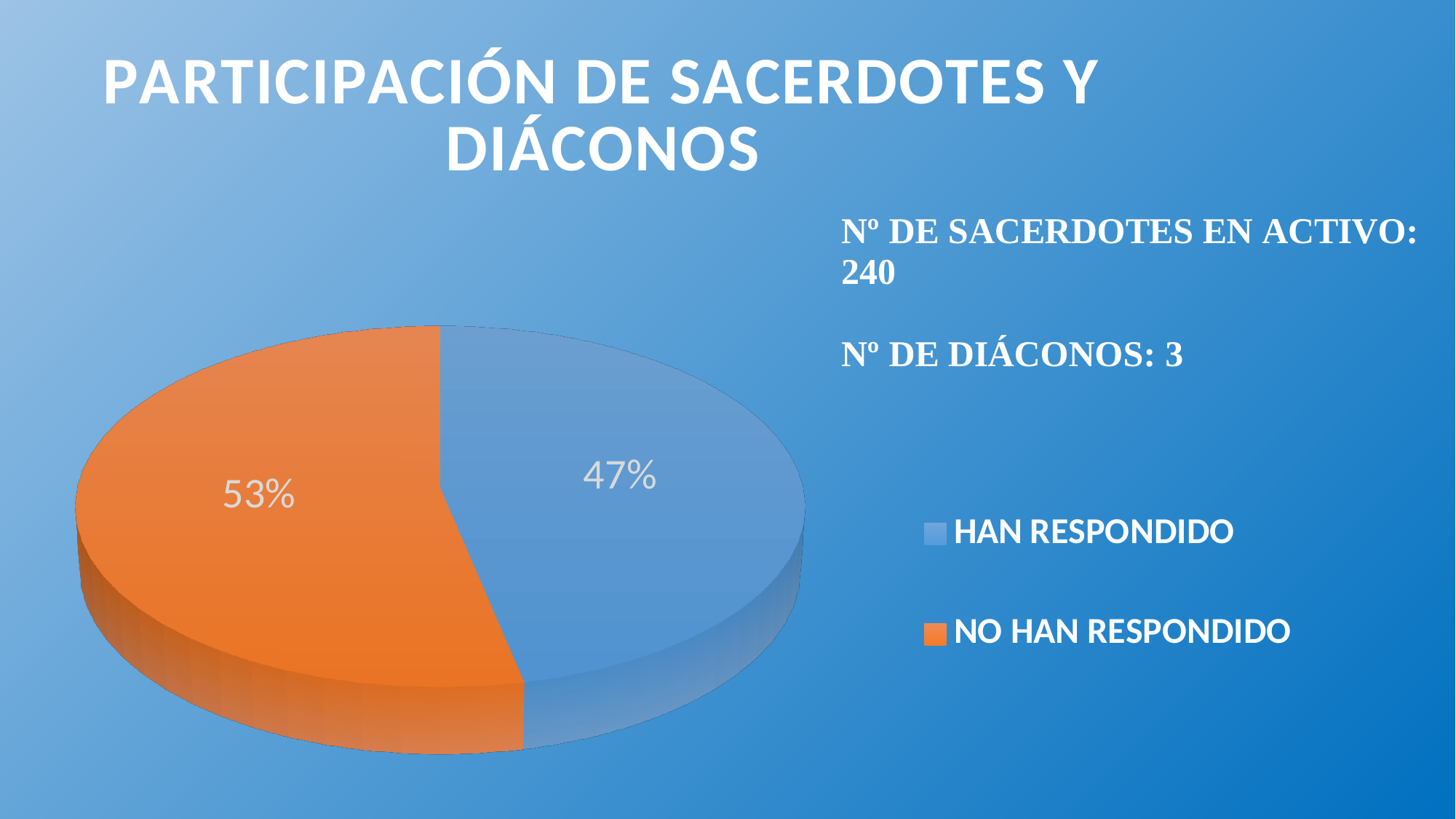
Which is larger, the HAN RESPONDIDO slice or the NO HAN RESPONDIDO slice? NO HAN RESPONDIDO What percentage of the pie is labelled HAN RESPONDIDO? 47% What colour is the NO HAN RESPONDIDO slice? Orange Which slice of the pie is the smallest? HAN RESPONDIDO What is the difference in percentage points between the NO HAN RESPONDIDO slice and the HAN RESPONDIDO slice? 6 Which slice of the pie is the largest? NO HAN RESPONDIDO What percentage of the pie is labelled NO HAN RESPONDIDO? 53% How many entries does the legend list? 2 What colour is the HAN RESPONDIDO slice? Blue How many slices does the pie chart have? 2 What kind of chart is shown on the slide? Pie chart What share of the pie does the HAN RESPONDIDO slice represent? 47%